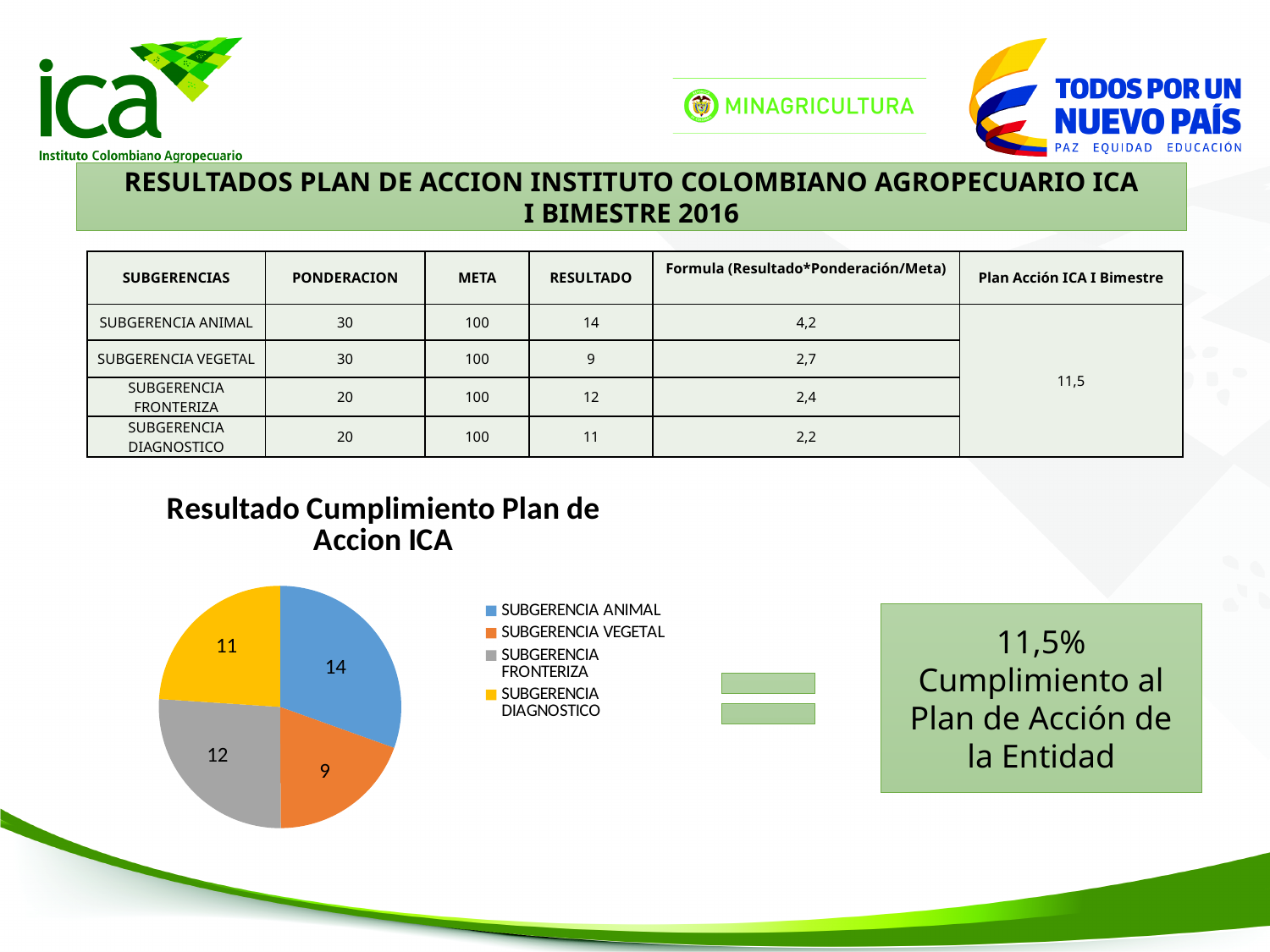
How many categories does the pie chart show? 4 What is the value for SUBGERENCIA ANIMAL in the pie chart? 14 Which is larger in the pie chart, SUBGERENCIA FRONTERIZA or SUBGERENCIA DIAGNOSTICO? SUBGERENCIA FRONTERIZA Which colour represents SUBGERENCIA DIAGNOSTICO in the pie chart? yellow What type of chart is shown on the slide? pie chart What is the title of the pie chart? Resultado Cumplimiento Plan de Accion ICA What is the value for SUBGERENCIA FRONTERIZA in the pie chart? 12 What is the difference between the values for SUBGERENCIA ANIMAL and SUBGERENCIA VEGETAL in the pie chart? 5 Which category has the largest slice in the pie chart? SUBGERENCIA ANIMAL Which category has the smallest slice in the pie chart? SUBGERENCIA VEGETAL What is the value for SUBGERENCIA VEGETAL in the pie chart? 9 What is the value for SUBGERENCIA DIAGNOSTICO in the pie chart? 11